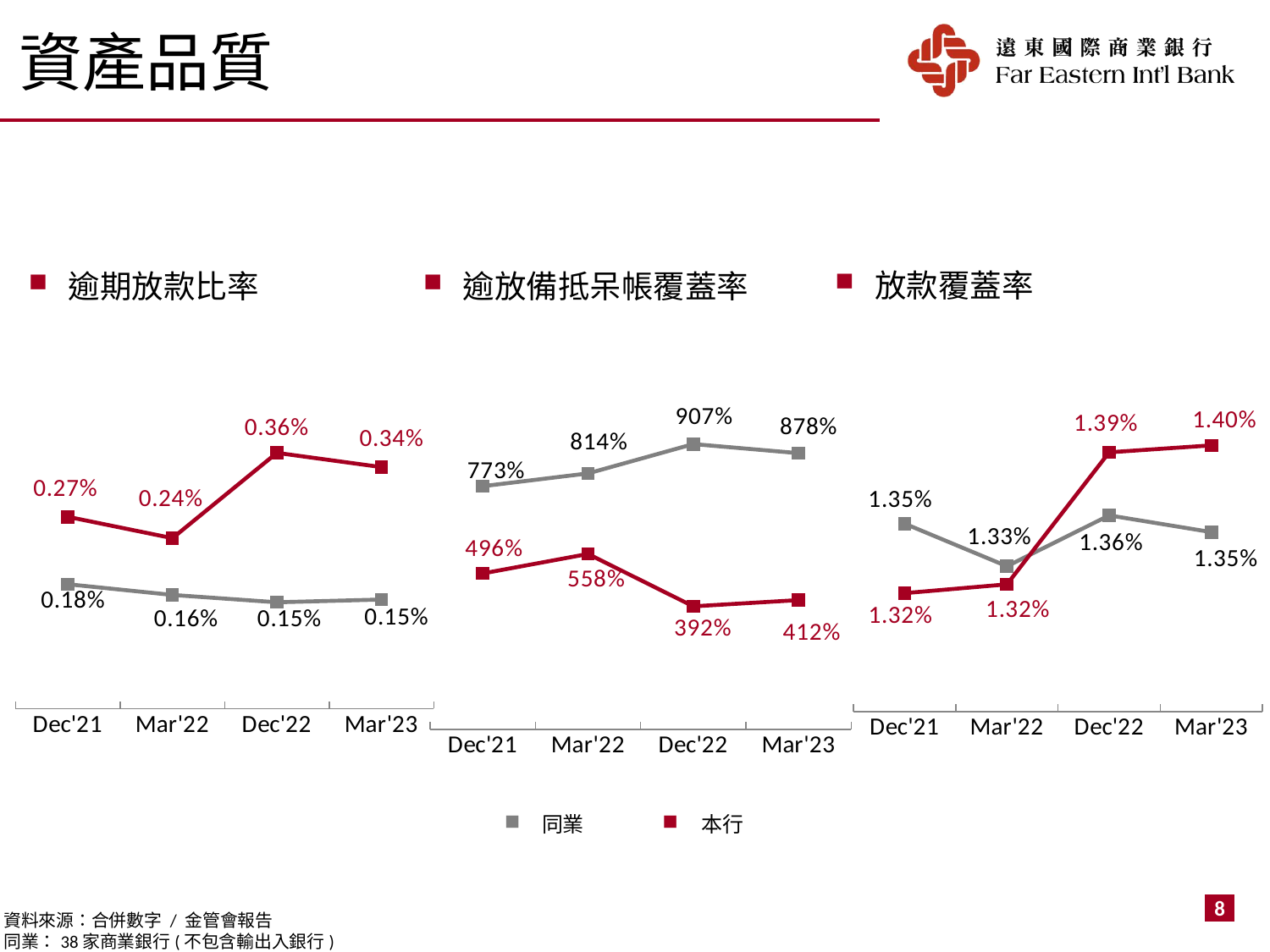
In the 逾放備抵呆帳覆蓋率 chart (middle), what is the difference between the 同業 and 本行 values at Mar'23? 466% In the 逾期放款比率 chart (left), what is the value for 同業 at Mar'23? 0.15% In the 逾期放款比率 chart (left), what is the difference between the 本行 and 同業 values at Dec'21? 0.09% What kind of chart is the 逾放備抵呆帳覆蓋率 chart (middle)? Line chart How many periods are shown on the x axis of the 逾期放款比率 chart (left)? 4 In the 放款覆蓋率 chart (right), which series has the higher value at Dec'21, 同業 or 本行? 同業 In the 逾期放款比率 chart (left), what is the value for 本行 at Dec'22? 0.36% In the 逾放備抵呆帳覆蓋率 chart (middle), at which period is the 本行 value lowest? Dec'22 In the 逾放備抵呆帳覆蓋率 chart (middle), what is the value for 同業 at Dec'22? 907% In the 放款覆蓋率 chart (right), at which period is the 本行 value highest? Mar'23 How many series does the shared legend list? 2 In the 放款覆蓋率 chart (right), what is the value for 本行 at Mar'23? 1.40%